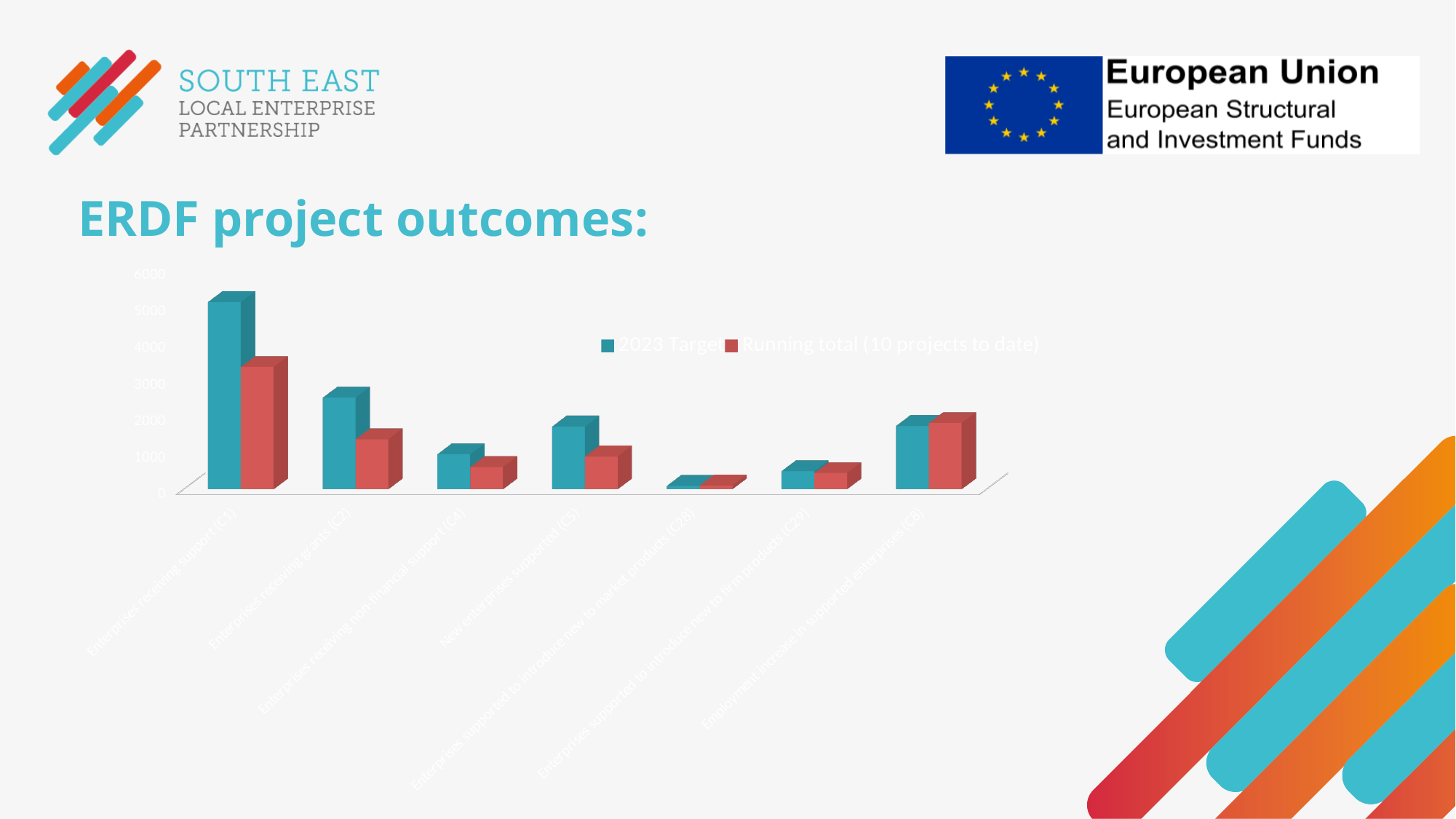
Is the 2023 Target value for Enterprises supported to introduce new to market products (C28) greater or less than 1000? less How many categories are plotted along the x axis of the chart? 7 Which category has the lowest 2023 Target value? Enterprises supported to introduce new to market products (C28) Which category has the highest 2023 Target value? Enterprises receiving support (C1) Is the 2023 Target value for Enterprises receiving grants (C2) greater or less than 2000? greater How many series does the chart legend list? 2 Is the Running total value for Enterprises receiving support (C1) greater or less than 3000? greater What is the name of the second series in the chart legend? Running total (10 projects to date) What is the title of the slide containing the chart? ERDF project outcomes: For Enterprises receiving support (C1), which is larger: the 2023 Target or the Running total? 2023 Target What kind of chart is shown on the slide? bar chart